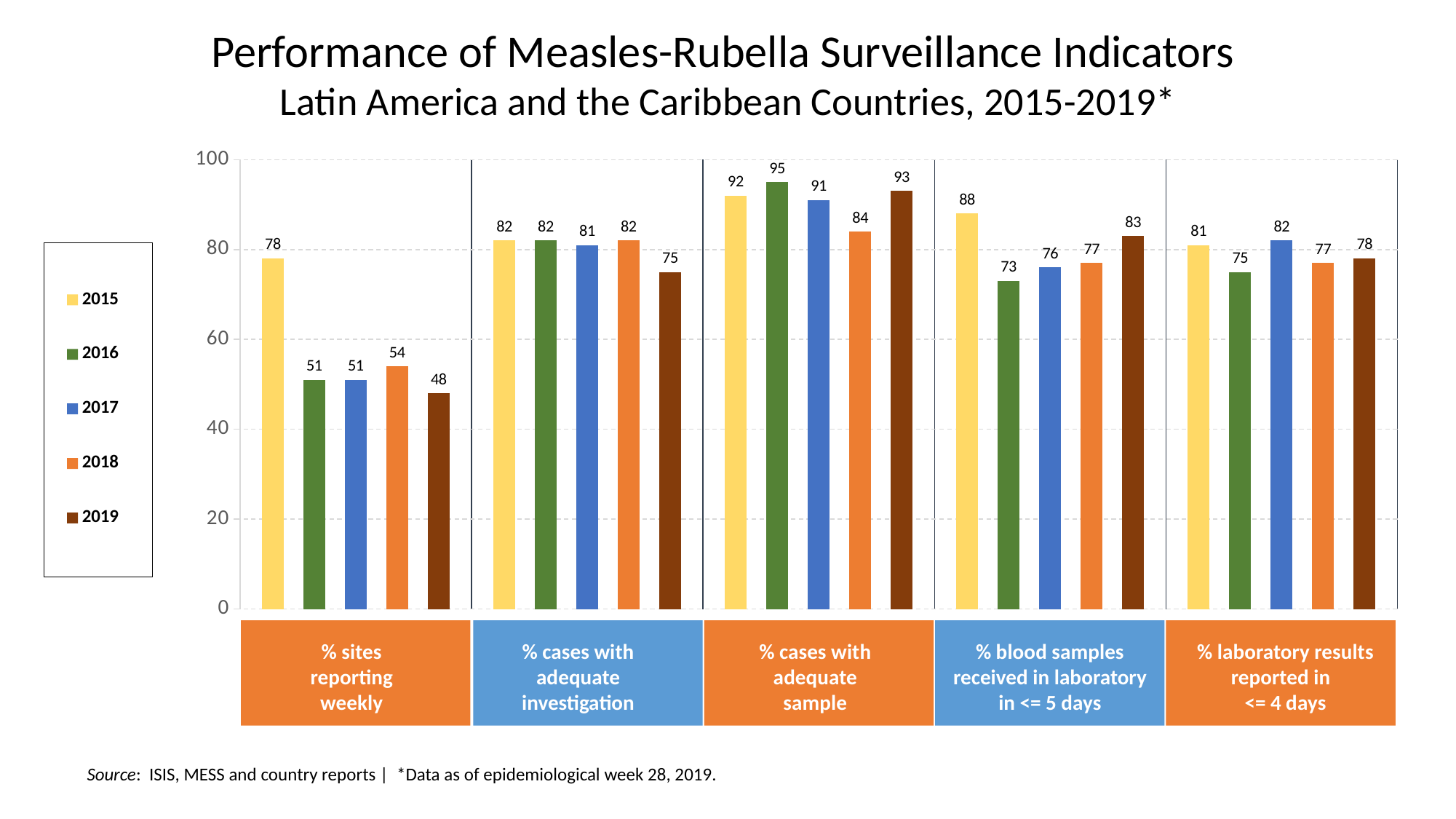
Which colour represents 2018 in the legend? Orange What kind of chart is shown on the slide? Bar chart What is the value for 2018 in the '% blood samples received in laboratory in <= 5 days' category? 77 What is the difference between the 2015 and 2019 values in the '% sites reporting weekly' category? 30 What is the value for 2016 in the '% cases with adequate sample' category? 95 Which is larger in the '% laboratory results reported in <= 4 days' category: the 2017 value or the 2016 value? 2017 Which year has the lowest value in the '% sites reporting weekly' category? 2019 What is the value for 2019 in the '% cases with adequate investigation' category? 75 How many series does the legend list? 5 How many indicator categories are shown on the x axis? 5 Which year has the highest value in the '% blood samples received in laboratory in <= 5 days' category? 2015 What is the value for 2015 in the '% sites reporting weekly' category? 78